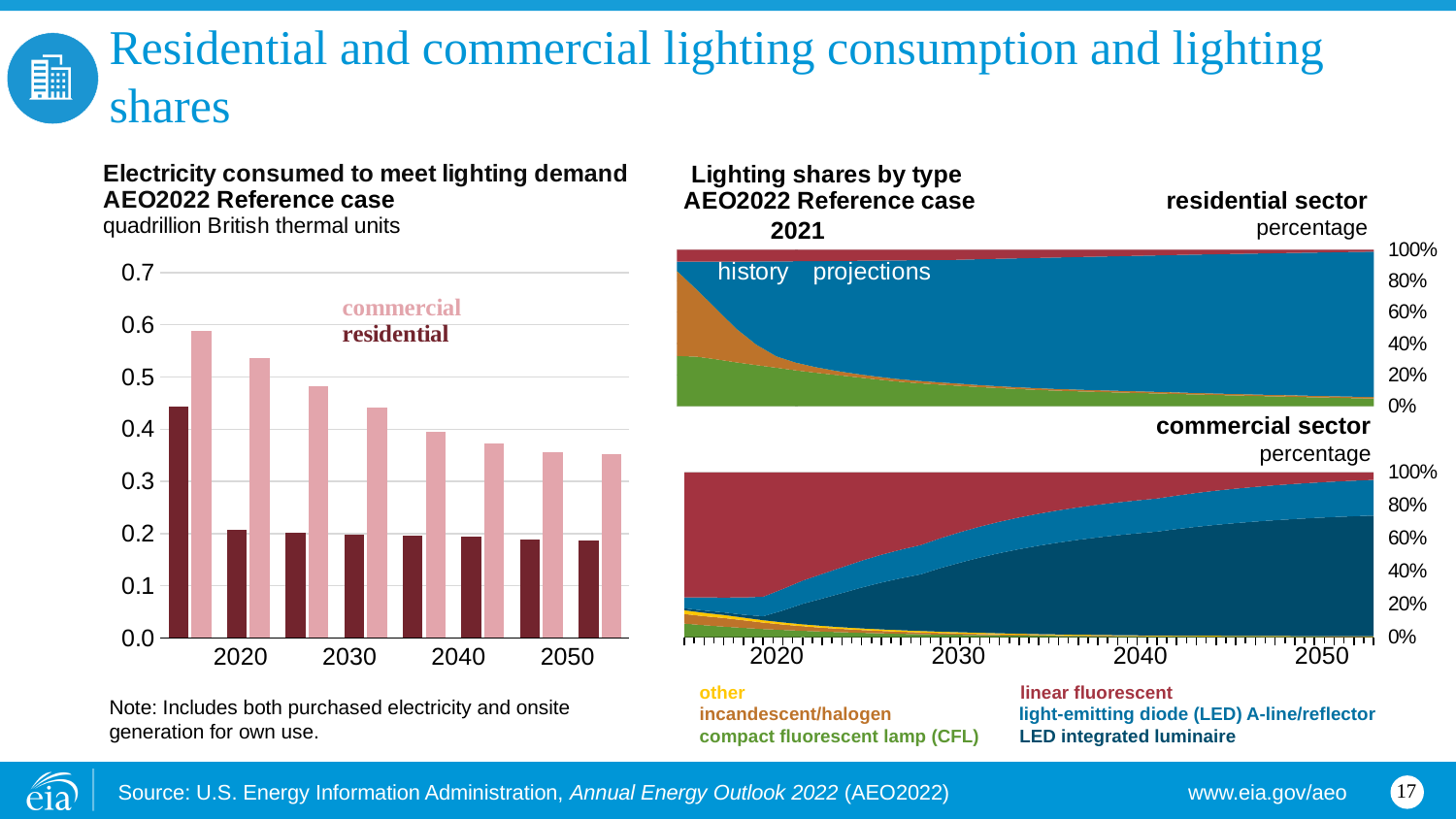
How many lighting types does the legend of the 'Lighting shares by type' charts list? 6 What kind of chart is the 'Electricity consumed to meet lighting demand' chart on the left? bar chart In the 'Lighting shares by type' commercial sector chart, which lighting type has the largest share in 2050? LED integrated luminaire In the 'Electricity consumed to meet lighting demand' chart, does commercial lighting consumption rise or fall from 2020 to 2050? fall In the 'Lighting shares by type' commercial sector chart, is the linear fluorescent share in 2020 greater or less than 60%? greater In the 'Electricity consumed to meet lighting demand' chart, is the residential value in 2050 greater or less than 0.3 quadrillion Btu? less In the 'Electricity consumed to meet lighting demand' chart, which series is larger in 2020, commercial or residential? commercial In the 'Electricity consumed to meet lighting demand' chart, is the commercial value in 2020 greater or less than 0.5 quadrillion Btu? greater What unit is used on the y axis of the 'Electricity consumed to meet lighting demand' chart? quadrillion British thermal units In the 'Lighting shares by type' residential sector chart, which lighting type has the largest share in 2050? light-emitting diode (LED) A-line/reflector How many series does the 'Electricity consumed to meet lighting demand' chart show? 2